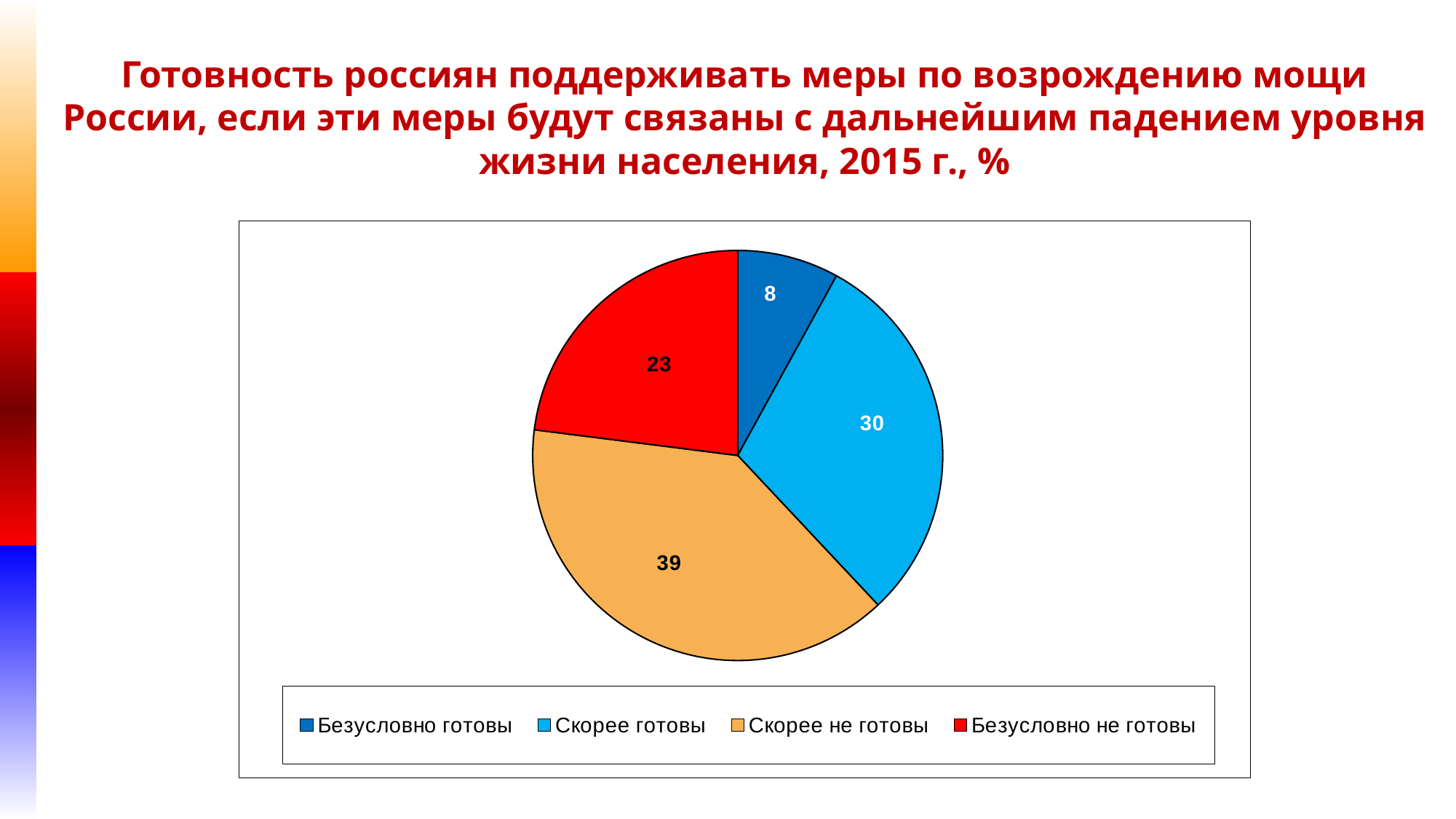
What is the difference between the values for "Скорее не готовы" and "Скорее готовы"? 9 How many slices does the pie chart have? 4 What is the value for "Безусловно готовы"? 8 Which category has the smallest slice? Безусловно готовы What is the value for "Скорее готовы"? 30 What colour is the slice for "Безусловно не готовы"? Red What type of chart is shown on the slide? Pie chart What is the value for "Безусловно не готовы"? 23 Which category has the largest slice? Скорее не готовы How many entries does the legend list? 4 What is the value for "Скорее не готовы"? 39 Which is larger, the value for "Скорее готовы" or the value for "Безусловно не готовы"? Скорее готовы